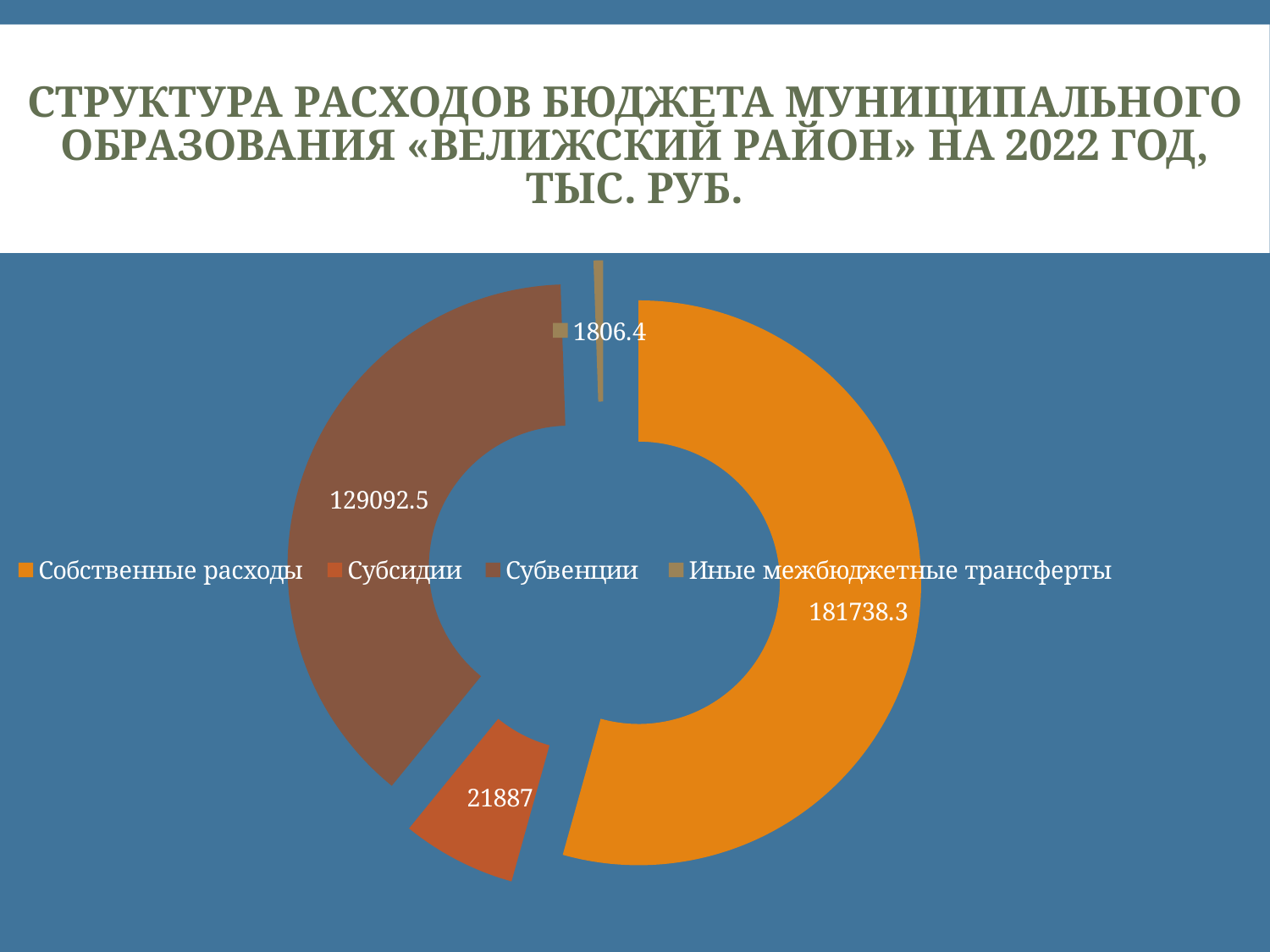
What is the value for Субвенции? 129092.5 What is the value for Собственные расходы? 181738.3 What is the difference between Собственные расходы and Субвенции? 52645.8 How many categories does the chart show? 4 What is the value for Иные межбюджетные трансферты? 1806.4 What kind of chart is shown on the slide? doughnut chart Which category has the largest value? Собственные расходы What is the value for Субсидии? 21887 Which is larger, Субсидии or Субвенции? Субвенции What is the difference between Субвенции and Субсидии? 107205.5 What colour is the Собственные расходы slice? orange Which category has the smallest value? Иные межбюджетные трансферты